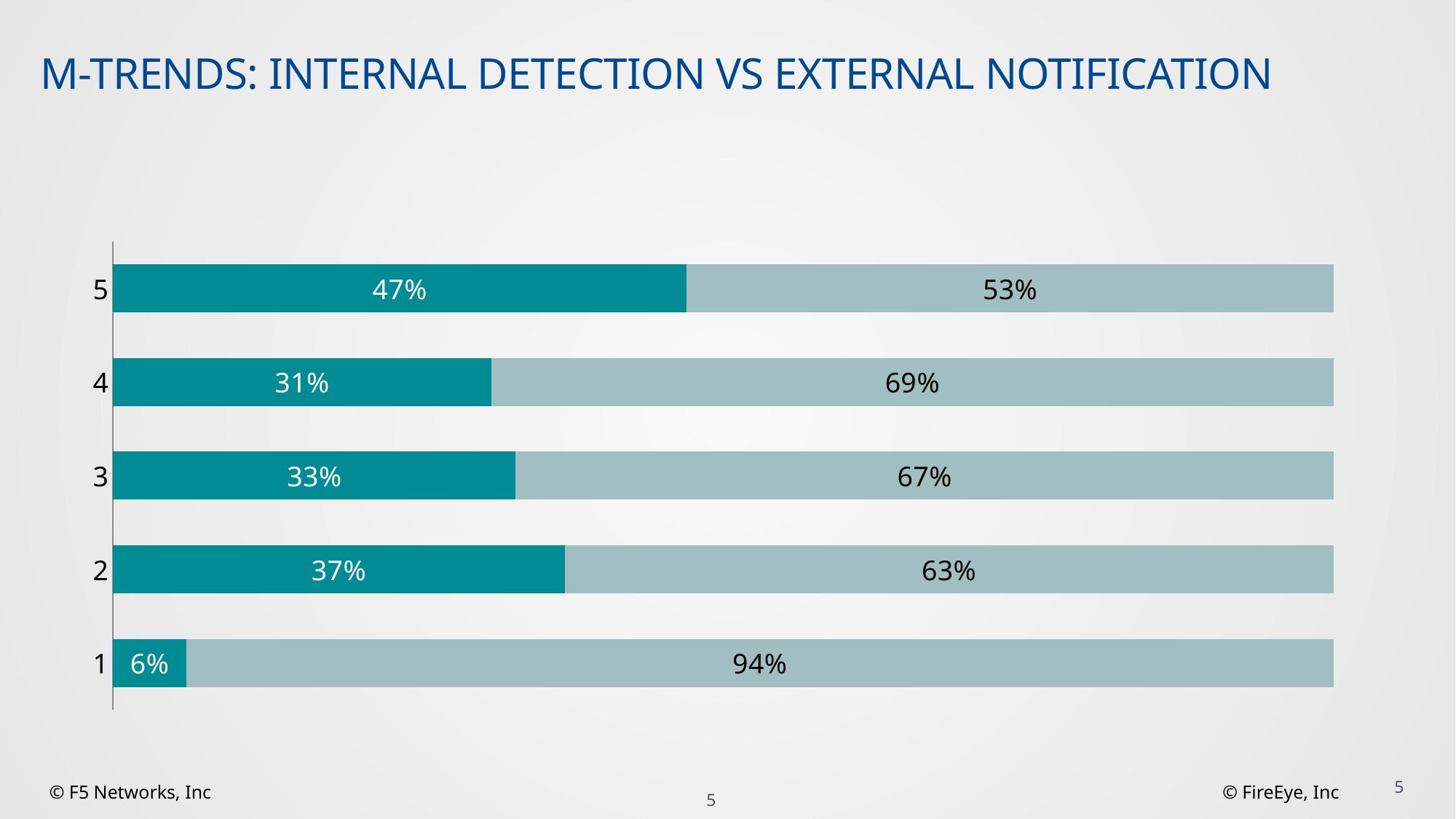
What is the difference between the light grey and dark teal segments for category 4? 38% Which has a larger dark teal segment, category 2 or category 3? Category 2 Which category has the smallest dark teal segment? 1 What kind of chart is shown on the slide? Stacked bar chart What is the value of the dark teal segment for category 4? 31% How many categories are shown on the chart? 5 What is the value of the light grey segment for category 1? 94% What is the total of the stacked bar for category 3? 100% What is the value of the light grey segment for category 2? 63% Which category has the largest light grey segment? 1 What is the value of the dark teal segment for category 5? 47% Which category has the largest dark teal segment? 5